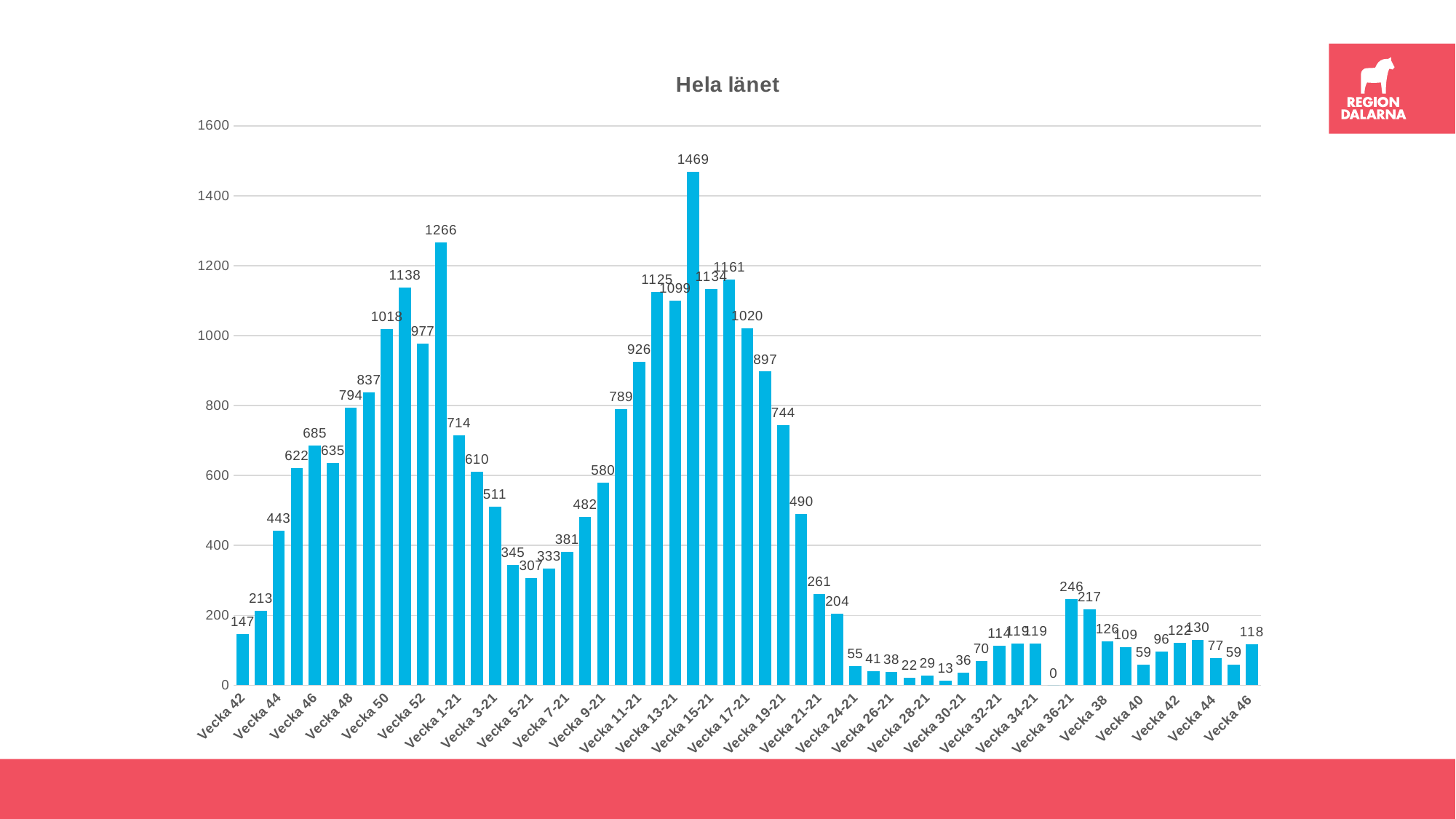
What is the value for Vecka 24-21? 55 What is the value for Vecka 36-21? 246 What is the title of the chart? Hela länet Do the values rise or fall from Vecka 42 to Vecka 50 at the start of the chart? rise What is the highest value shown in the chart? 1469 What is the lowest value shown in the chart? 0 Which has the larger value, Vecka 11-21 or Vecka 19-21? Vecka 11-21 What is the value for Vecka 1-21? 714 What is the value for Vecka 50? 1018 What kind of chart is shown on the slide? bar chart Is the value for Vecka 13-21 greater or less than 1000? greater What is the difference between the values for Vecka 50 and Vecka 48? 224